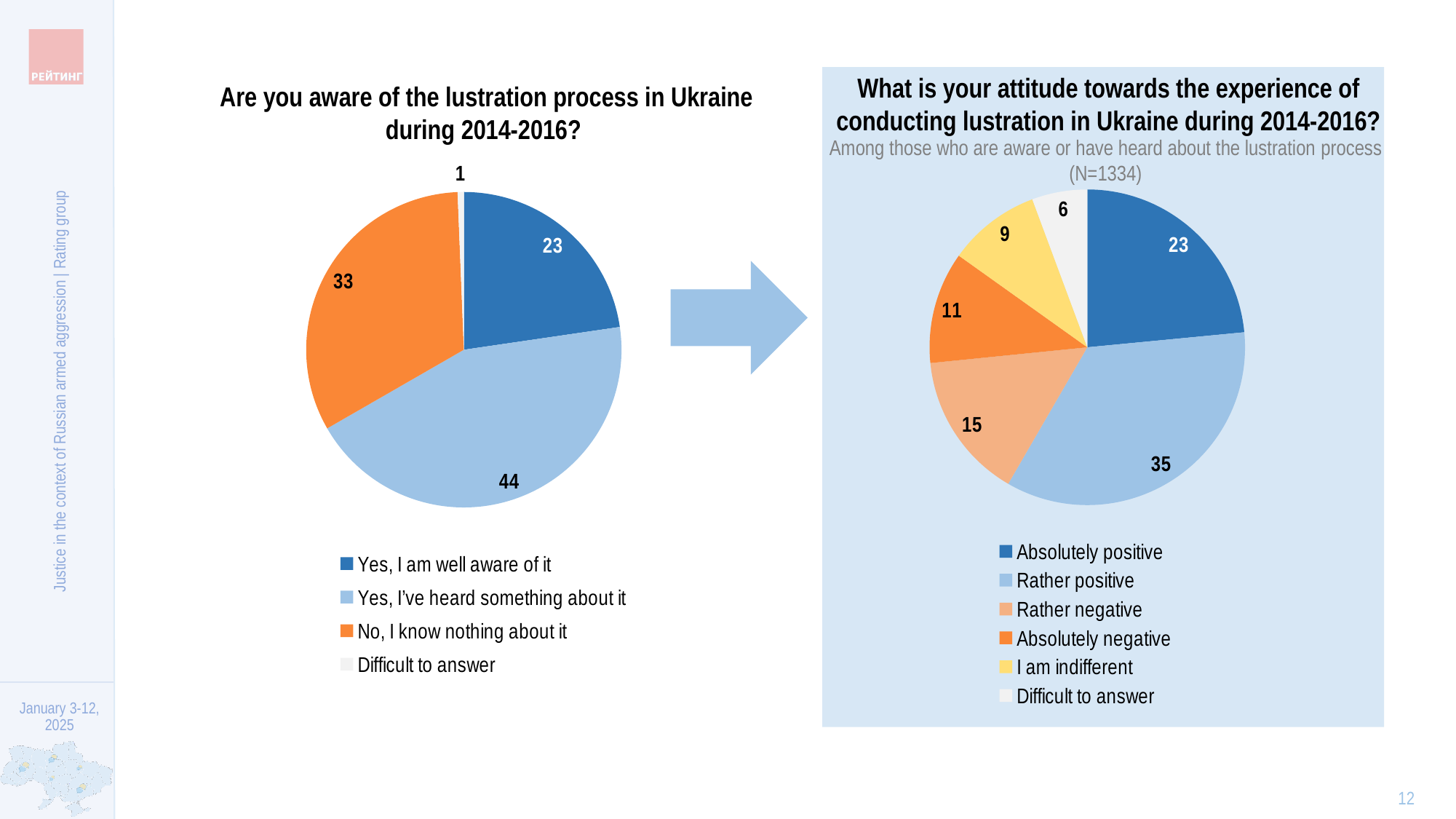
In the left chart 'Are you aware of the lustration process in Ukraine during 2014-2016?', which category has the largest slice? Yes, I've heard something about it In the right chart 'What is your attitude towards the experience of conducting lustration in Ukraine during 2014-2016?', which category has the largest slice? Rather positive In the left chart 'Are you aware of the lustration process in Ukraine during 2014-2016?', what is the value for 'No, I know nothing about it'? 33 In the left chart 'Are you aware of the lustration process in Ukraine during 2014-2016?', how many categories does the legend list? 4 In the right chart 'What is your attitude towards the experience of conducting lustration in Ukraine during 2014-2016?', what is the value for 'I am indifferent'? 9 In the left chart 'Are you aware of the lustration process in Ukraine during 2014-2016?', what is the value for 'Yes, I've heard something about it'? 44 In the left chart 'Are you aware of the lustration process in Ukraine during 2014-2016?', which category has the smallest slice? Difficult to answer In the right chart 'What is your attitude towards the experience of conducting lustration in Ukraine during 2014-2016?', what is the value for 'Rather negative'? 15 In the right chart 'What is your attitude towards the experience of conducting lustration in Ukraine during 2014-2016?', which is larger, 'Absolutely positive' or 'Absolutely negative'? Absolutely positive What kind of chart is the right chart 'What is your attitude towards the experience of conducting lustration in Ukraine during 2014-2016?'? Pie chart In the left chart 'Are you aware of the lustration process in Ukraine during 2014-2016?', what is the difference between 'Yes, I've heard something about it' and 'Yes, I am well aware of it'? 21 In the right chart 'What is your attitude towards the experience of conducting lustration in Ukraine during 2014-2016?', how many categories does the legend list? 6